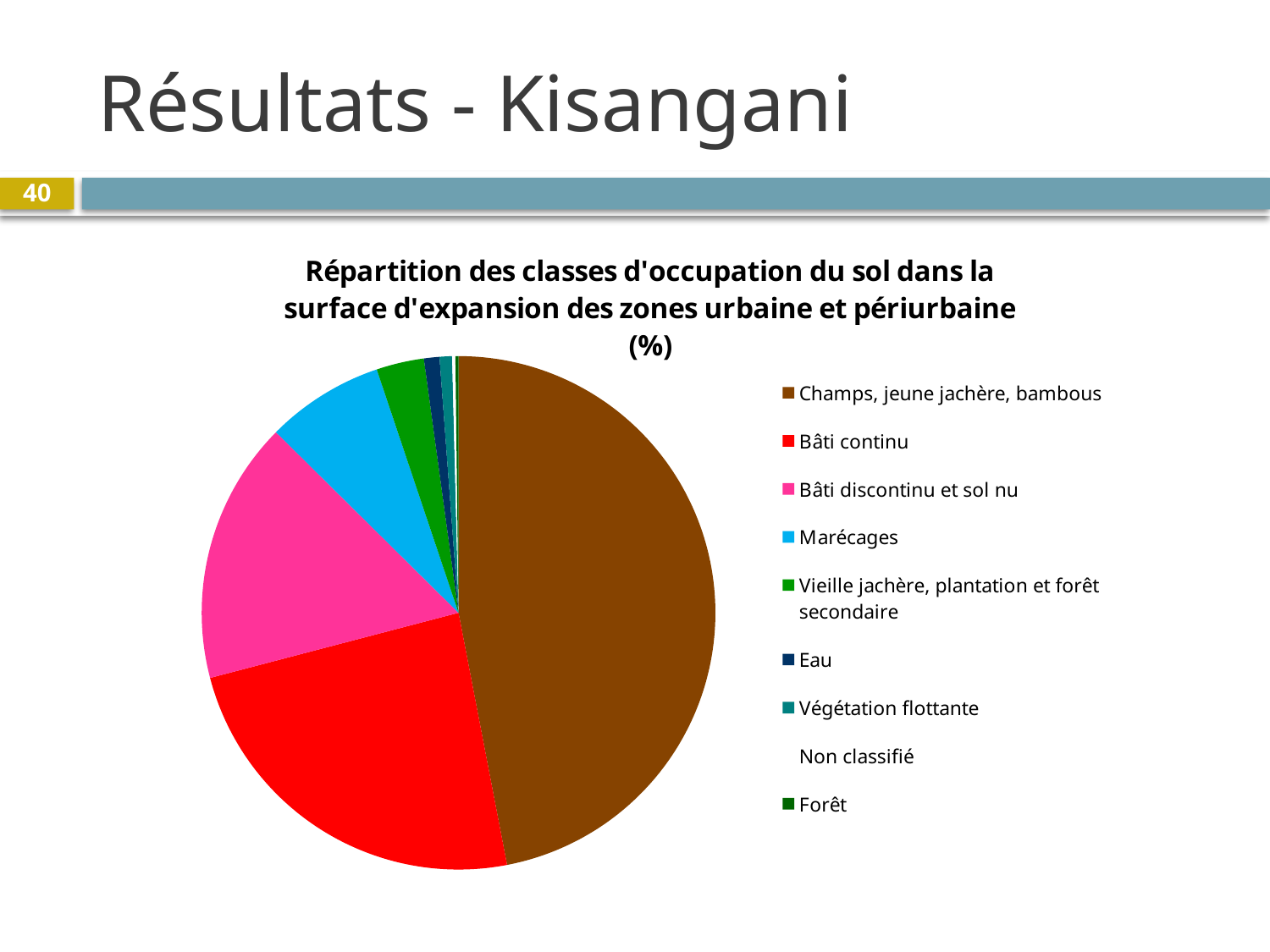
What kind of chart is shown on the slide? pie chart Which slice is larger: Bâti continu or Bâti discontinu et sol nu? Bâti continu Which slice is larger: Marécages or Vieille jachère, plantation et forêt secondaire? Marécages Which slice is larger: Eau or Bâti continu? Bâti continu What is the title of the pie chart? Répartition des classes d'occupation du sol dans la surface d'expansion des zones urbaine et périurbaine (%) How many categories does the pie chart's legend list? 9 Which category has the largest slice of the pie chart? Champs, jeune jachère, bambous Which category is shown in red in the pie chart? Bâti continu